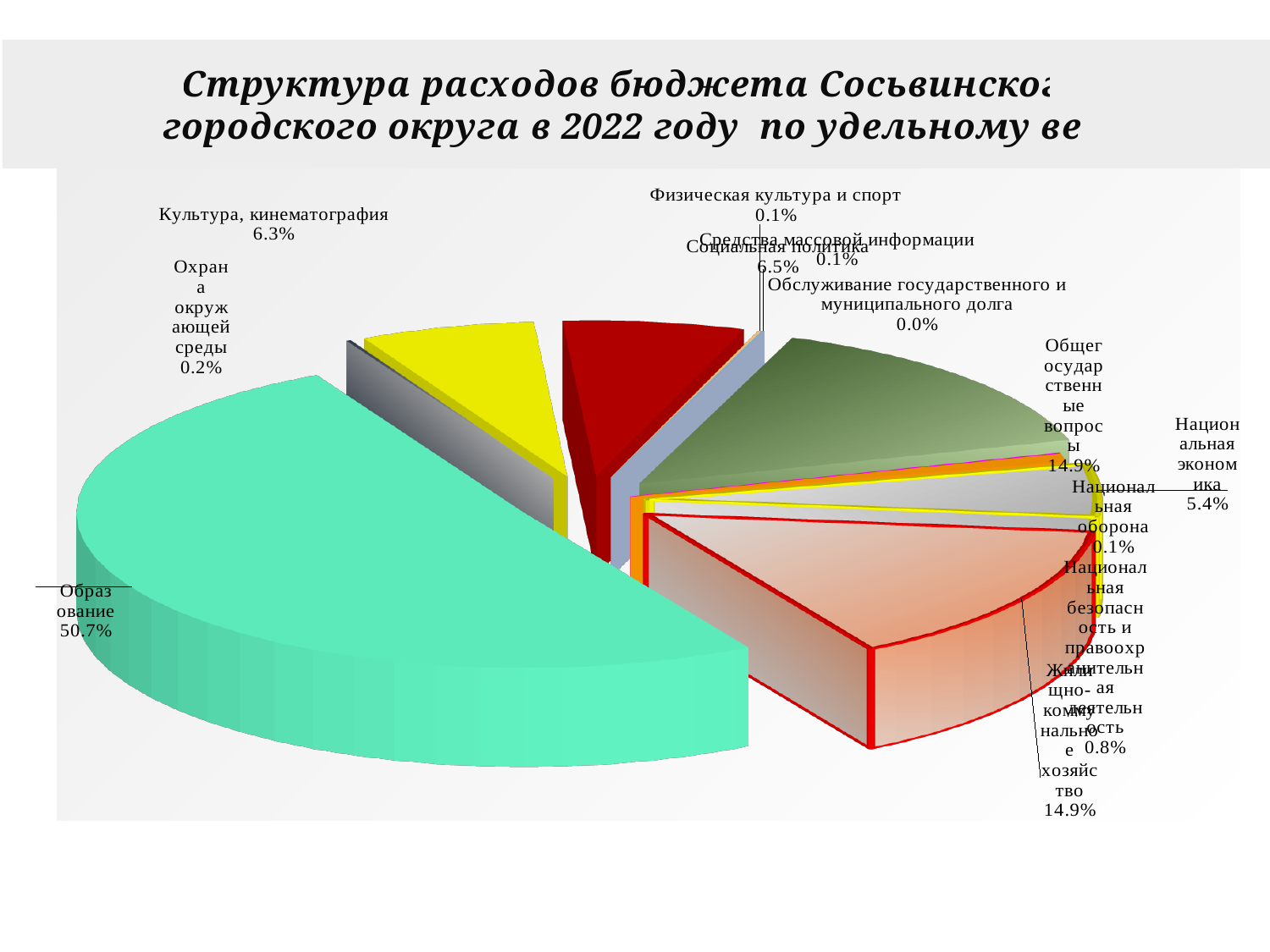
What kind of chart is shown on the slide? pie chart What is the value shown for Культура, кинематография? 6.3% How many categories are shown in the pie chart? 12 What is the difference between the shares of Образование and Общегосударственные вопросы? 35.8% What share of the budget expenditure goes to Образование? 50.7% Which category has the largest share of the budget expenditure? Образование Which is larger, the share for Социальная политика or the share for Национальная экономика? Социальная политика Which year does the chart title say the budget expenditure structure refers to? 2022 Which category has the smallest share of the budget expenditure? Обслуживание государственного и муниципального долга What is the value shown for Национальная экономика? 5.4% What is the value shown for Обслуживание государственного и муниципального долга? 0.0% What is the value shown for Жилищно-коммунальное хозяйство? 14.9%